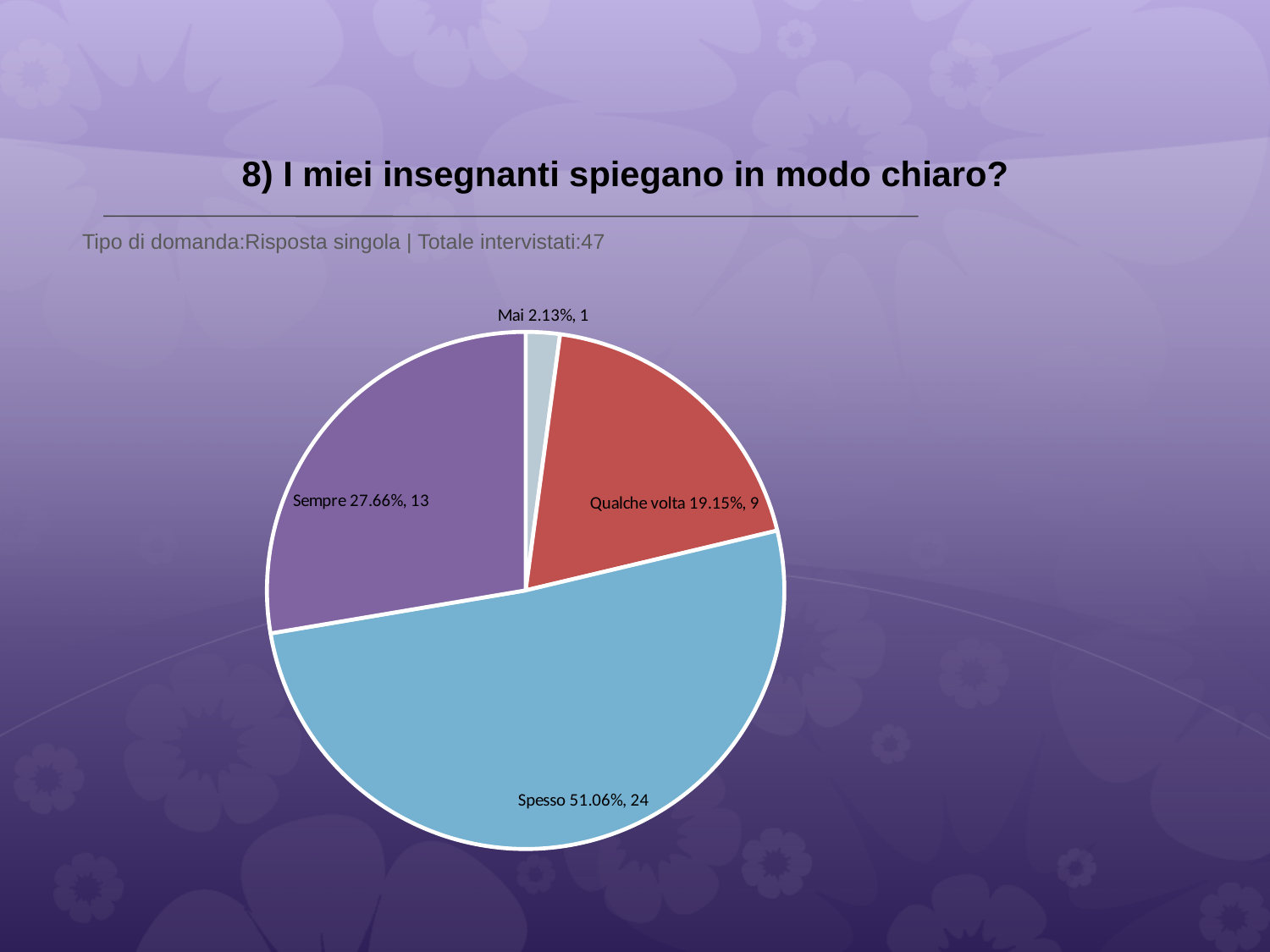
What kind of chart is shown on the slide? pie chart How many slices does the pie chart have? 4 What is the total number of respondents stated on the slide? 47 What is the title of the chart on the slide? 8) I miei insegnanti spiegano in modo chiaro? How many respondents answered 'Sempre'? 13 Which category has the smallest slice? Mai What percentage share does the 'Spesso' slice have? 51.06% How many respondents answered 'Mai'? 1 What is the difference in respondent count between 'Spesso' and 'Sempre'? 11 Which has more respondents, 'Sempre' or 'Qualche volta'? Sempre What percentage share does the 'Qualche volta' slice have? 19.15% Which category has the largest slice? Spesso